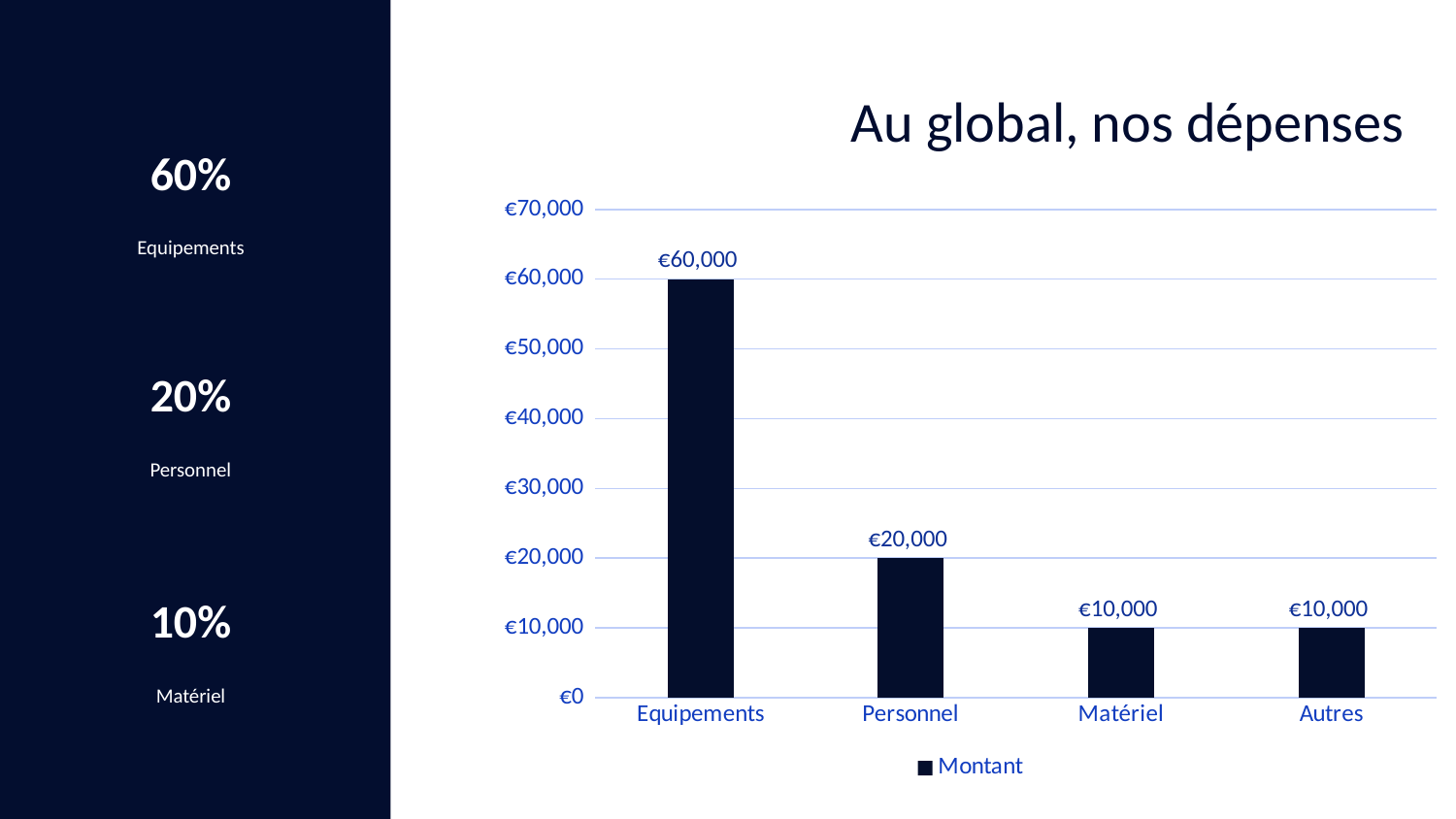
Which category has the highest value? Equipements What is the difference between the values for Equipements and Personnel? €40,000 What is the value for Autres? €10,000 What is the value for Equipements? €60,000 What is the value for Personnel? €20,000 What is the name of the series in the legend? Montant What kind of chart is shown? bar chart What is the title of the chart? Au global, nos dépenses Which is larger, the value for Personnel or the value for Matériel? Personnel How many categories are shown on the x axis? 4 How many series does the legend list? 1 Is the value for Equipements greater or less than €50,000? greater